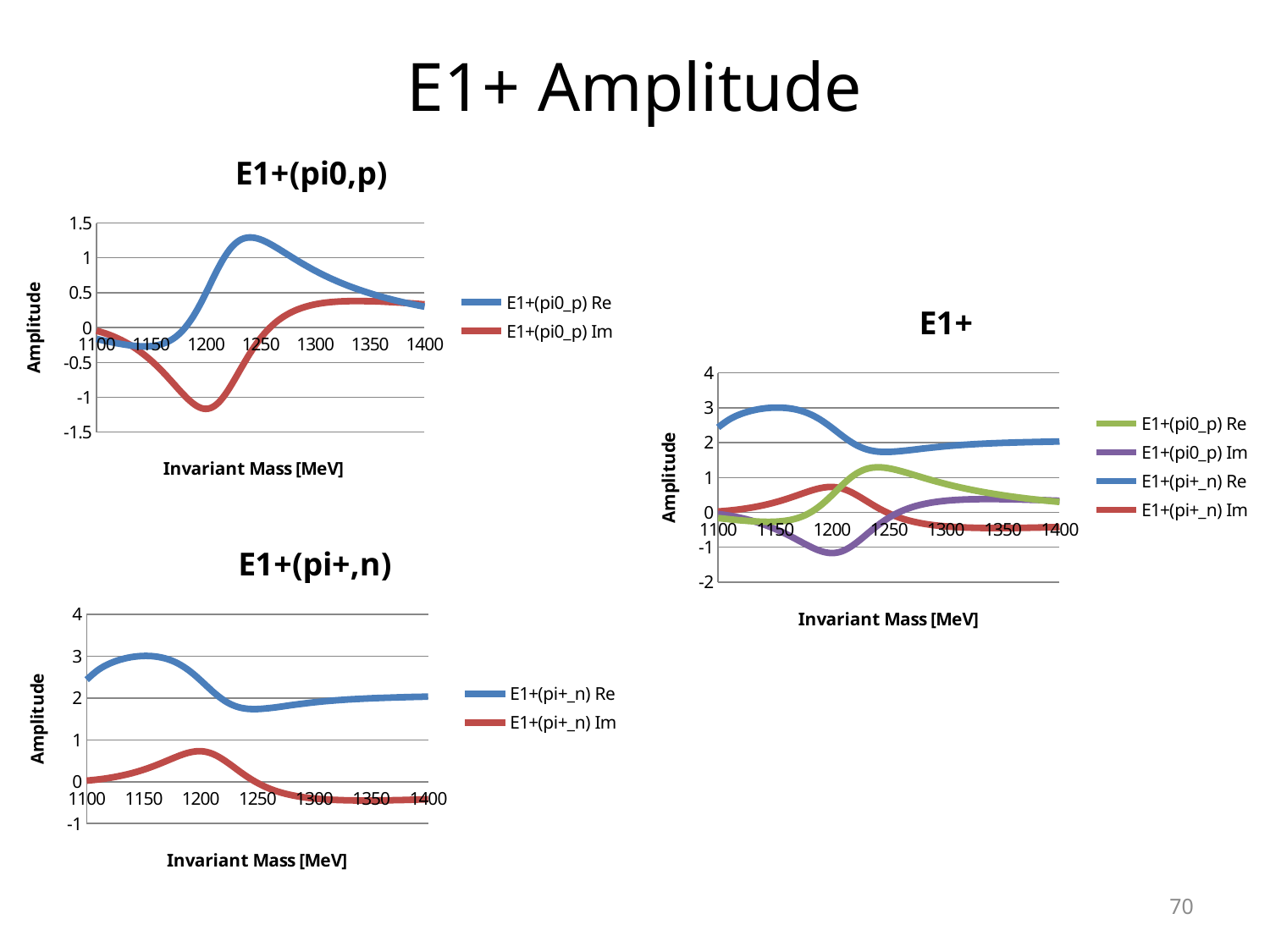
How many series does the legend of the "E1+(pi0,p)" chart list? 2 How many series does the legend of the "E1+" chart list? 4 In the "E1+(pi0,p)" chart, is the value of E1+(pi0_p) Re at 1400 greater or less than 0.5? less What is the x-axis title of the "E1+" chart? Invariant Mass [MeV] What kind of chart is the "E1+(pi0,p)" chart? line chart In the "E1+(pi0,p)" chart, is the value of E1+(pi0_p) Im at 1200 greater or less than -0.5? less In the "E1+(pi+,n)" chart, does E1+(pi+_n) Re rise or fall between 1150 and 1250? fall In the "E1+(pi+,n)" chart, at 1200 which series has the larger value, E1+(pi+_n) Re or E1+(pi+_n) Im? E1+(pi+_n) Re In the "E1+" chart, at 1100 which series has the larger value, E1+(pi+_n) Re or E1+(pi0_p) Re? E1+(pi+_n) Re In the "E1+" chart, what colour is the E1+(pi+_n) Re line? blue In the "E1+" chart, is the value of E1+(pi0_p) Re at 1250 greater or less than 1? greater